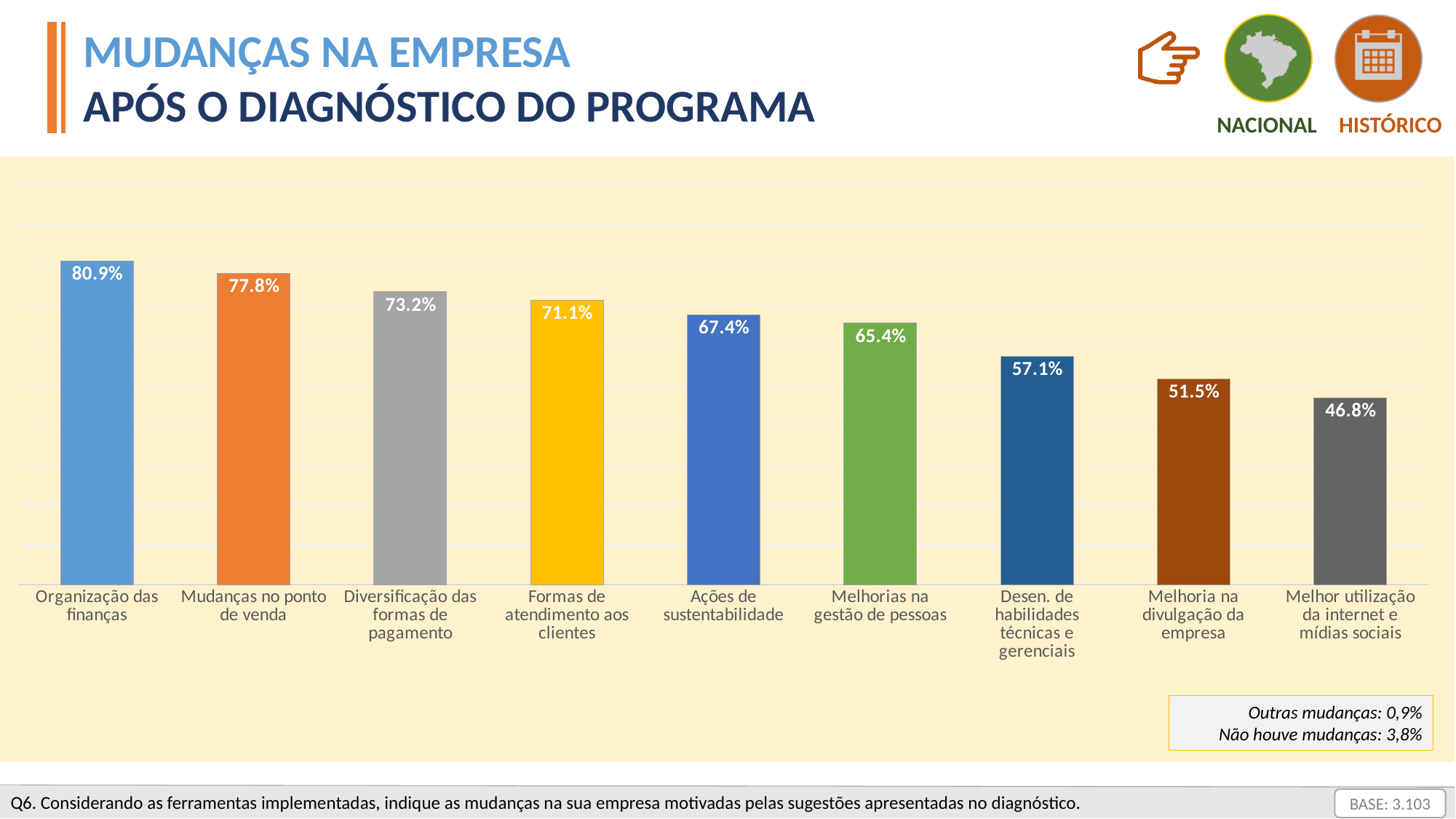
What is the value for Melhor utilização da internet e mídias sociais? 46.8% Which category has the lowest value? Melhor utilização da internet e mídias sociais What kind of chart is shown on the slide? Bar chart What is the value for Ações de sustentabilidade? 67.4% What is the difference between Mudanças no ponto de venda and Diversificação das formas de pagamento? 4.6% What is the difference between Melhoria na divulgação da empresa and Melhor utilização da internet e mídias sociais? 4.7% How many categories are shown in the bar chart? 9 What is the value for Organização das finanças? 80.9% Which is larger: Melhorias na gestão de pessoas or Desen. de habilidades técnicas e gerenciais? Melhorias na gestão de pessoas What percentage is given for 'Não houve mudanças' in the note box? 3,8% Do the values rise or fall from left to right across the categories? Fall Which category has the highest value? Organização das finanças